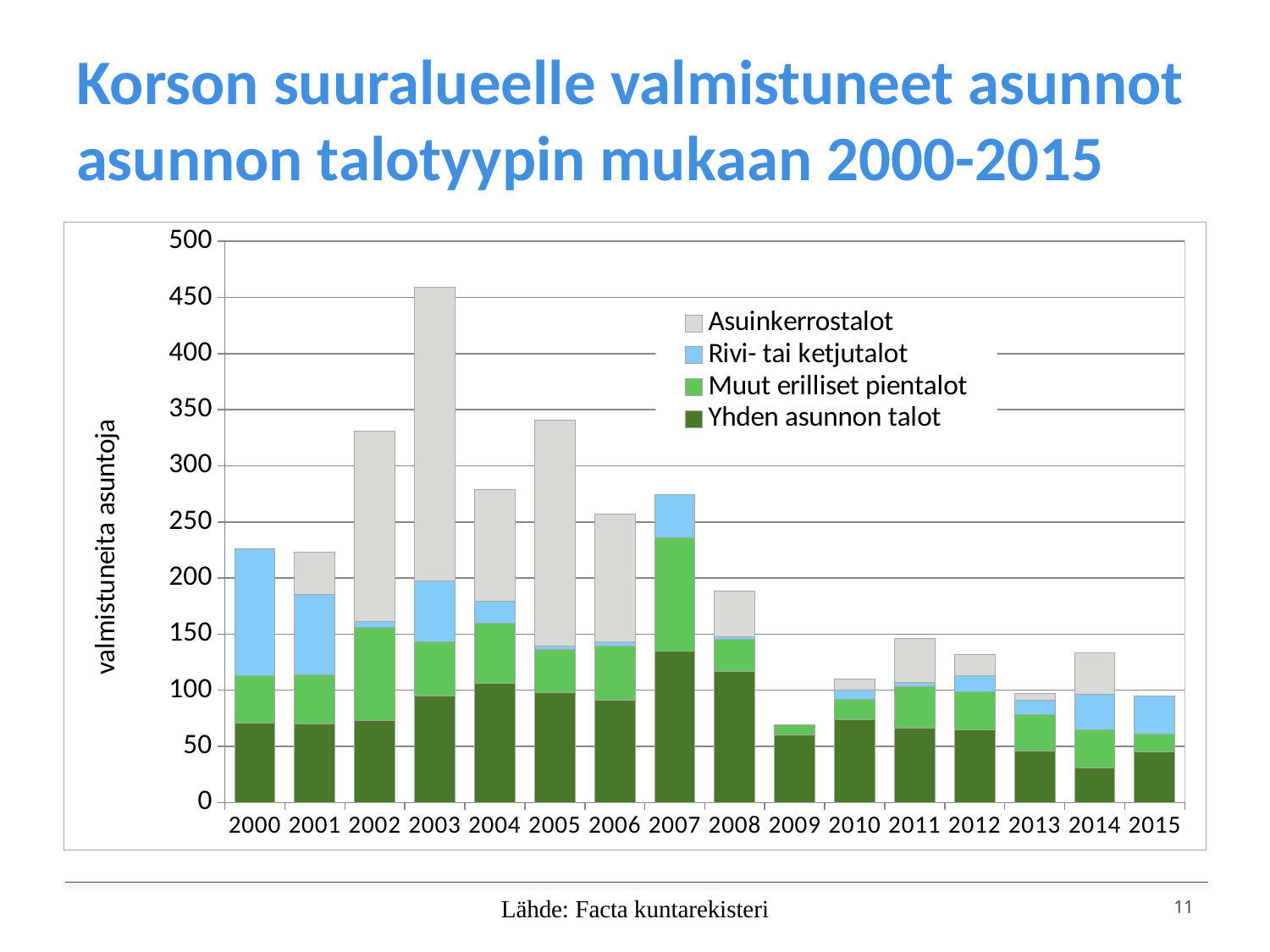
Which year has the lowest total bar in the chart? 2009 What kind of chart is shown on the slide? Stacked bar chart Which legend entry is shown in grey in the chart? Asuinkerrostalot Is the total value for 2009 greater or less than 100? less What is the label of the vertical axis of the chart? valmistuneita asuntoja Is the total value for 2007 greater or less than 250? greater Which year has the highest total bar in the chart? 2003 How many years are shown on the x axis of the chart? 16 Which year has a larger total bar, 2003 or 2005? 2003 Do the total bar heights rise or fall from 2007 to 2009? fall Is the total value for 2003 greater or less than 400? greater How many series does the chart's legend list? 4